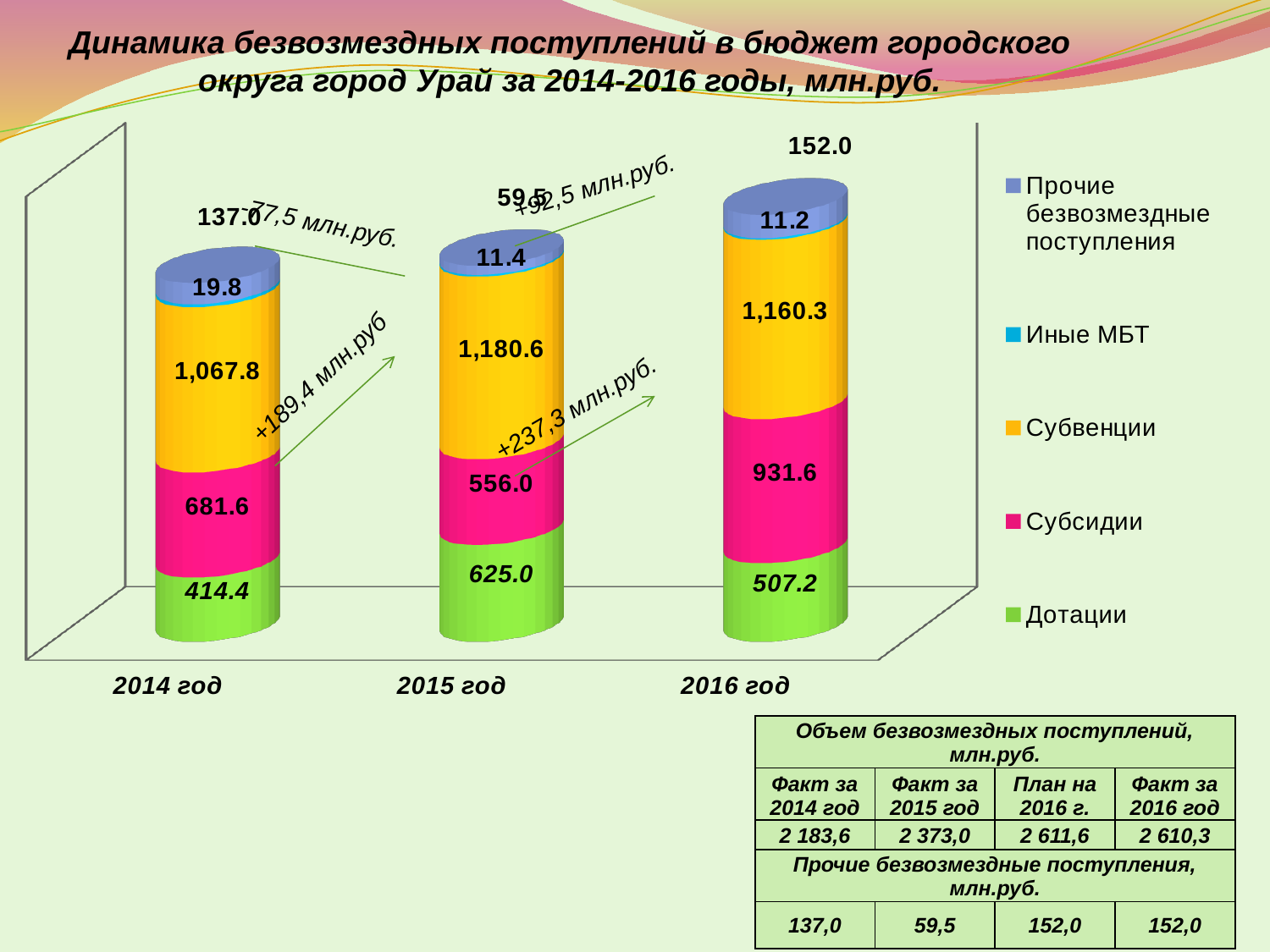
Does the Субсидии value rise or fall from 2015 год to 2016 год? Rise Which year has the larger Субсидии value, 2014 год or 2015 год? 2014 год What kind of chart is shown on the slide? Stacked bar chart How many series does the chart legend list? 5 How many years (categories) are shown on the x axis of the chart? 3 In which year is the Субвенции value the lowest? 2014 год What is the difference between the Субсидии values for 2016 год and 2015 год? 375.6 What is the value of Субвенции for 2015 год? 1,180.6 What is the value of Субсидии for 2016 год? 931.6 What is the value of Дотации for 2014 год? 414.4 In which year is the Дотации value the highest? 2015 год What colour represents Дотации in the chart legend? Green